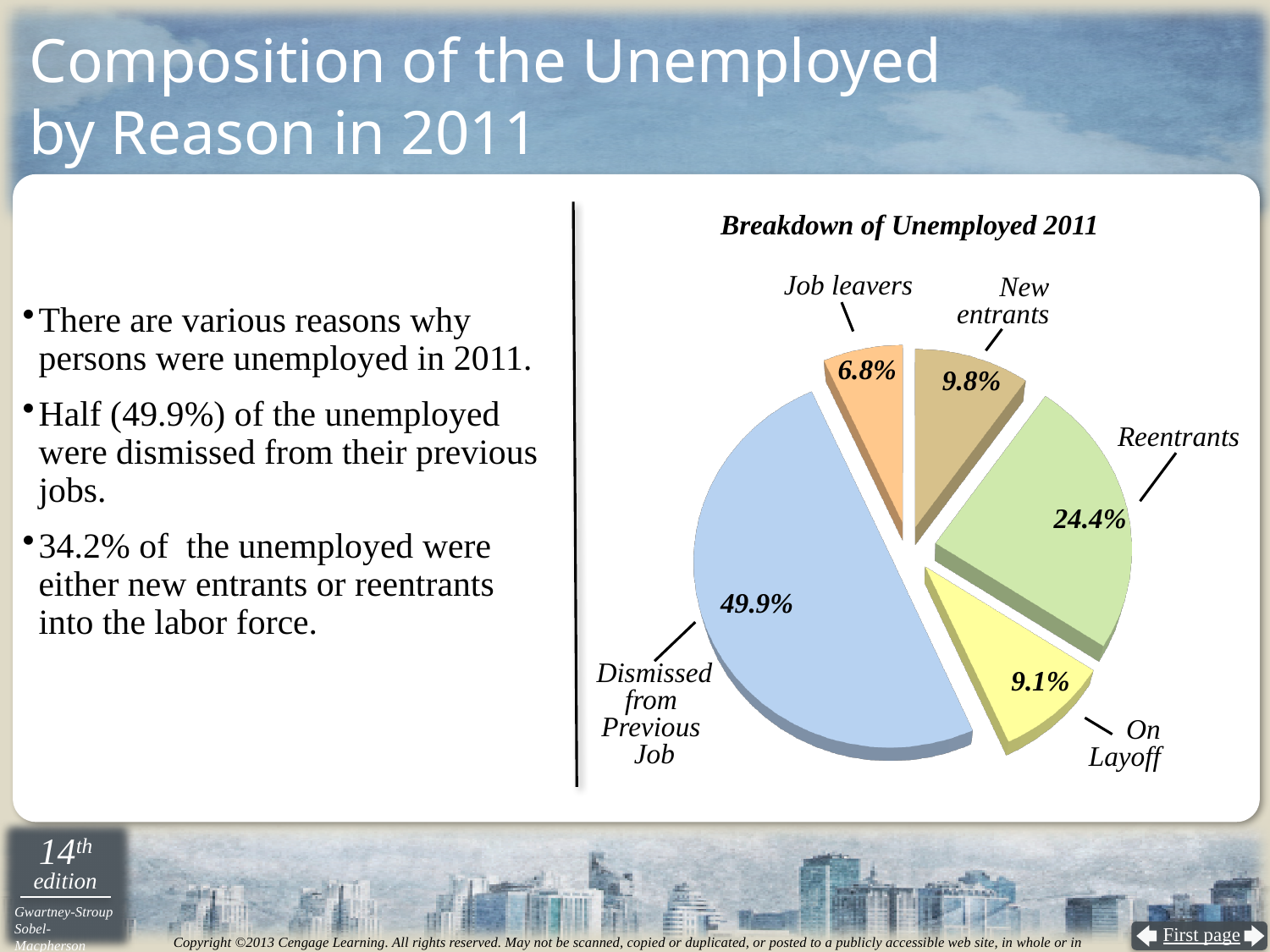
What share of the unemployed were New entrants? 9.8% What share of the unemployed were On Layoff? 9.1% What is the title of the chart? Breakdown of Unemployed 2011 What is the difference between the Reentrants share and the New entrants share? 14.6% Which category has the smallest slice of the pie? Job leavers What share of the unemployed were Reentrants? 24.4% What share of the unemployed were Dismissed from Previous Job? 49.9% Which is larger, the share for New entrants or the share for On Layoff? New entrants How many slices does the pie chart have? 5 Which category has the largest slice of the pie? Dismissed from Previous Job What kind of chart is shown on the slide? pie chart What share of the unemployed were Job leavers? 6.8%